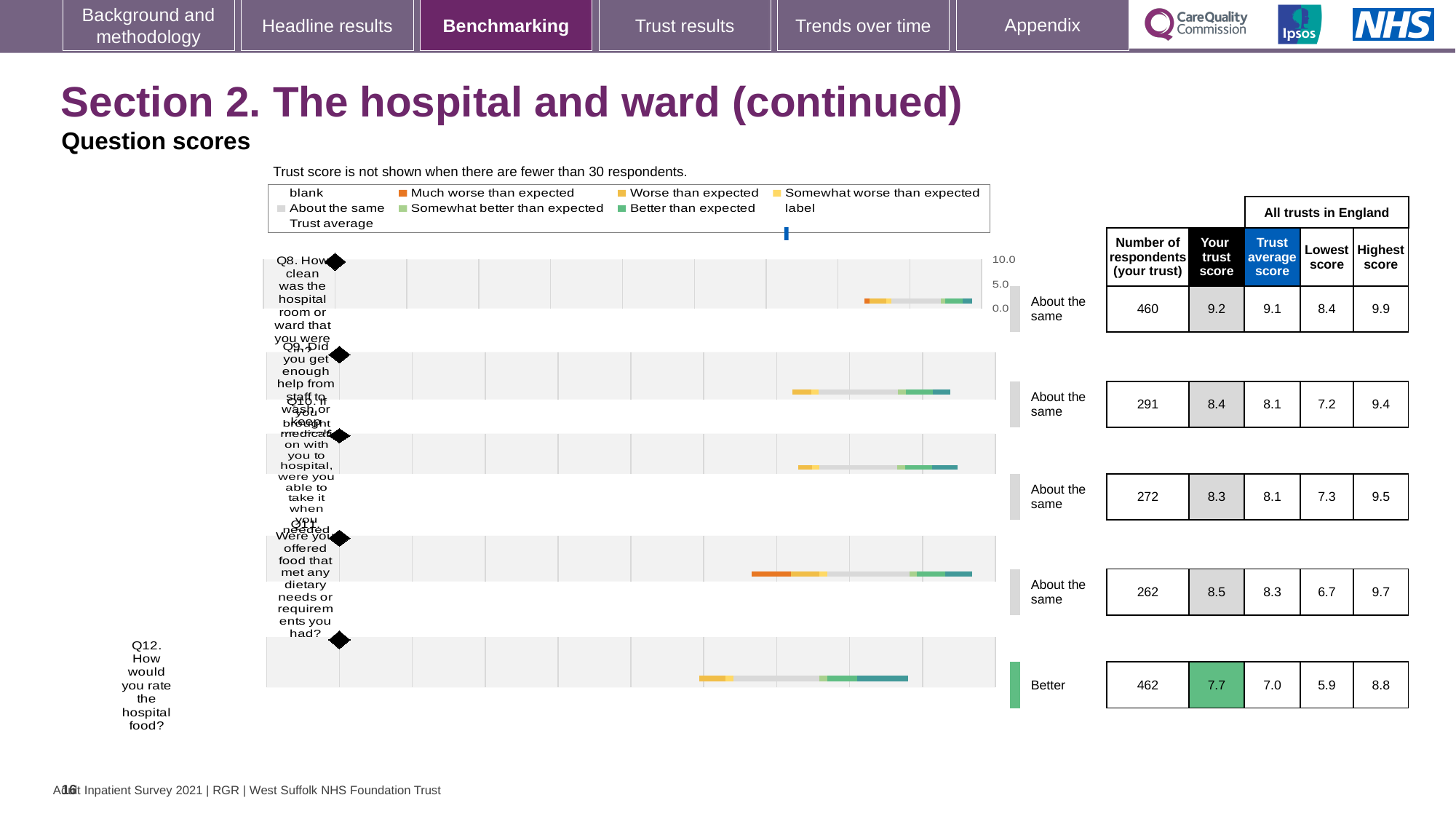
What is the lowest score among all trusts in England for Q10 (if you brought medication with you to hospital, were you able to take it when you needed to)? 7.3 How many respondents from the trust answered Q9 (did you get enough help from staff to wash or keep yourself clean)? 291 What is the difference between the trust score and the trust average score for Q12? 0.7 Which question has the lowest trust score? Q12 What is the highest score among all trusts in England for Q11 (were you offered food that met any dietary needs or requirements you had)? 9.7 What kind of chart is used to show the question scores? Bar chart How many questions are plotted on the chart? 5 Which is larger, the trust score for Q9 or the trust score for Q10? Q9 Which question has the highest trust score? Q8 Which question is rated 'Better' rather than 'About the same'? Q12 What is the trust average score across all trusts in England for Q12 (how would you rate the hospital food)? 7.0 What is the trust score for Q8 (how clean was the hospital room or ward)? 9.2